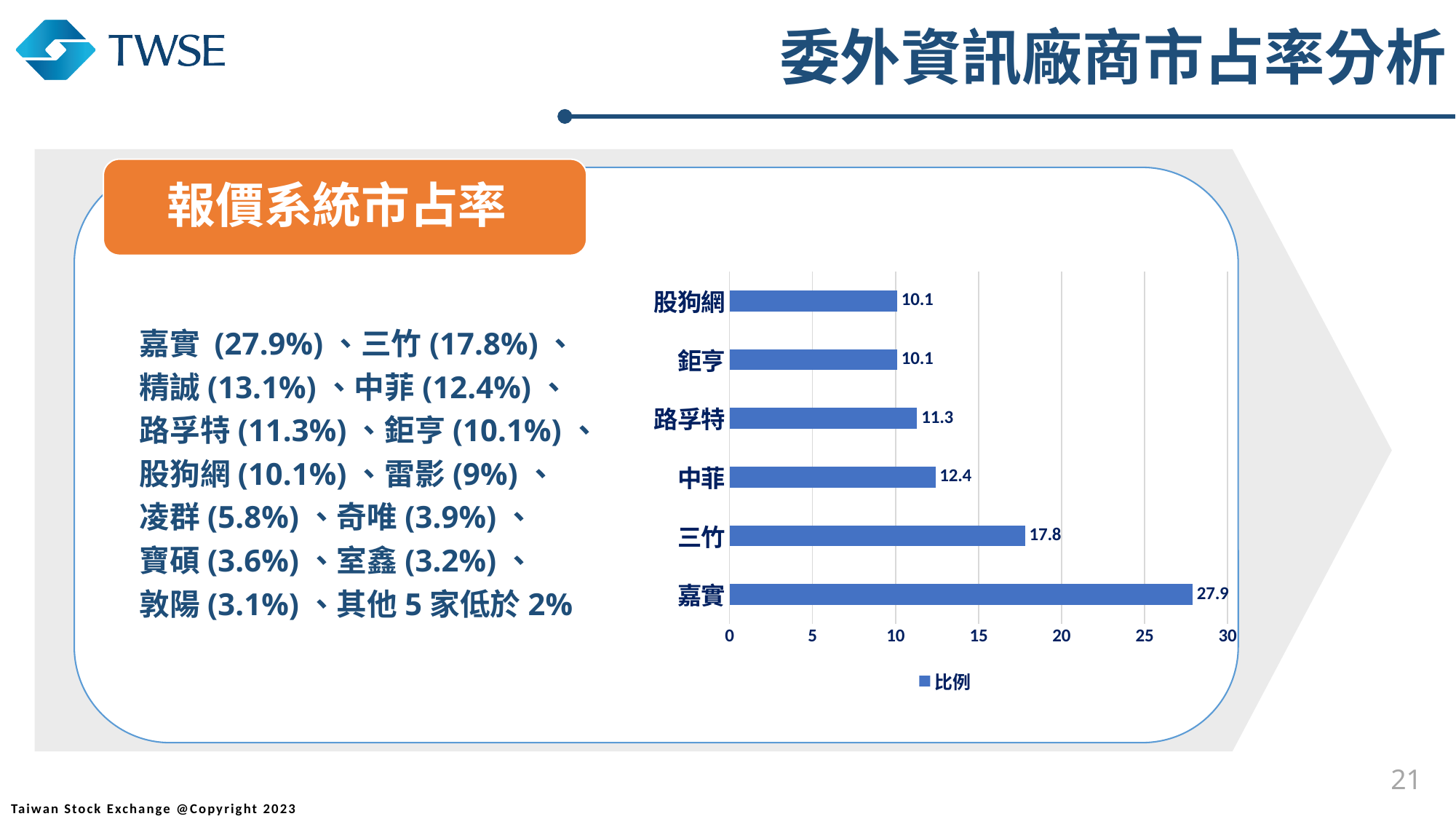
How many categories are shown in the bar chart? 6 What is the value for 三竹 in the bar chart? 17.8 What is the value for 中菲 in the bar chart? 12.4 What is the difference between the values for 嘉實 and 三竹? 10.1 Which category has the highest value in the bar chart? 嘉實 Which is larger, the value for 三竹 or the value for 中菲? 三竹 How many series does the chart legend list? 1 What is the value for 路孚特 in the bar chart? 11.3 What is the value for 嘉實 in the bar chart? 27.9 What is the difference between the values for 中菲 and 路孚特? 1.1 Is the value for 嘉實 greater or less than 25? greater What type of chart is shown on the slide? bar chart